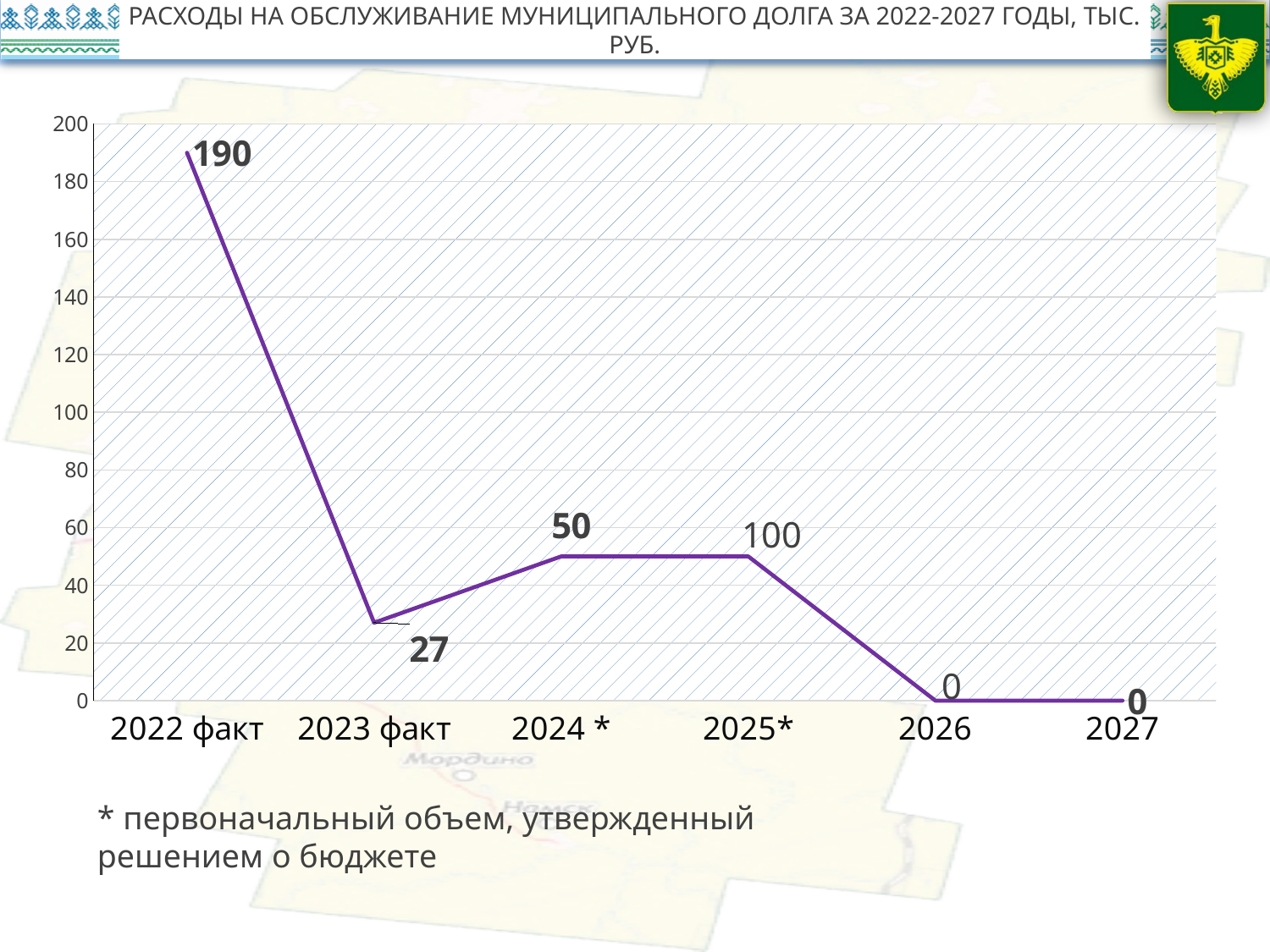
Is the value for 2022 факт greater or less than 180? greater What is the value for 2022 факт? 190 What is the difference between the values for 2024 * and 2023 факт? 23 What is the difference between the values for 2022 факт and 2023 факт? 163 What is the value for 2027? 0 What kind of chart is shown on the slide? line chart What is the value for 2023 факт? 27 What is the value for 2024 *? 50 Which year has the highest value? 2022 факт What is the value for 2026? 0 How many years are plotted on the x axis? 6 Which is larger, the value for 2023 факт or the value for 2024 *? 2024 *